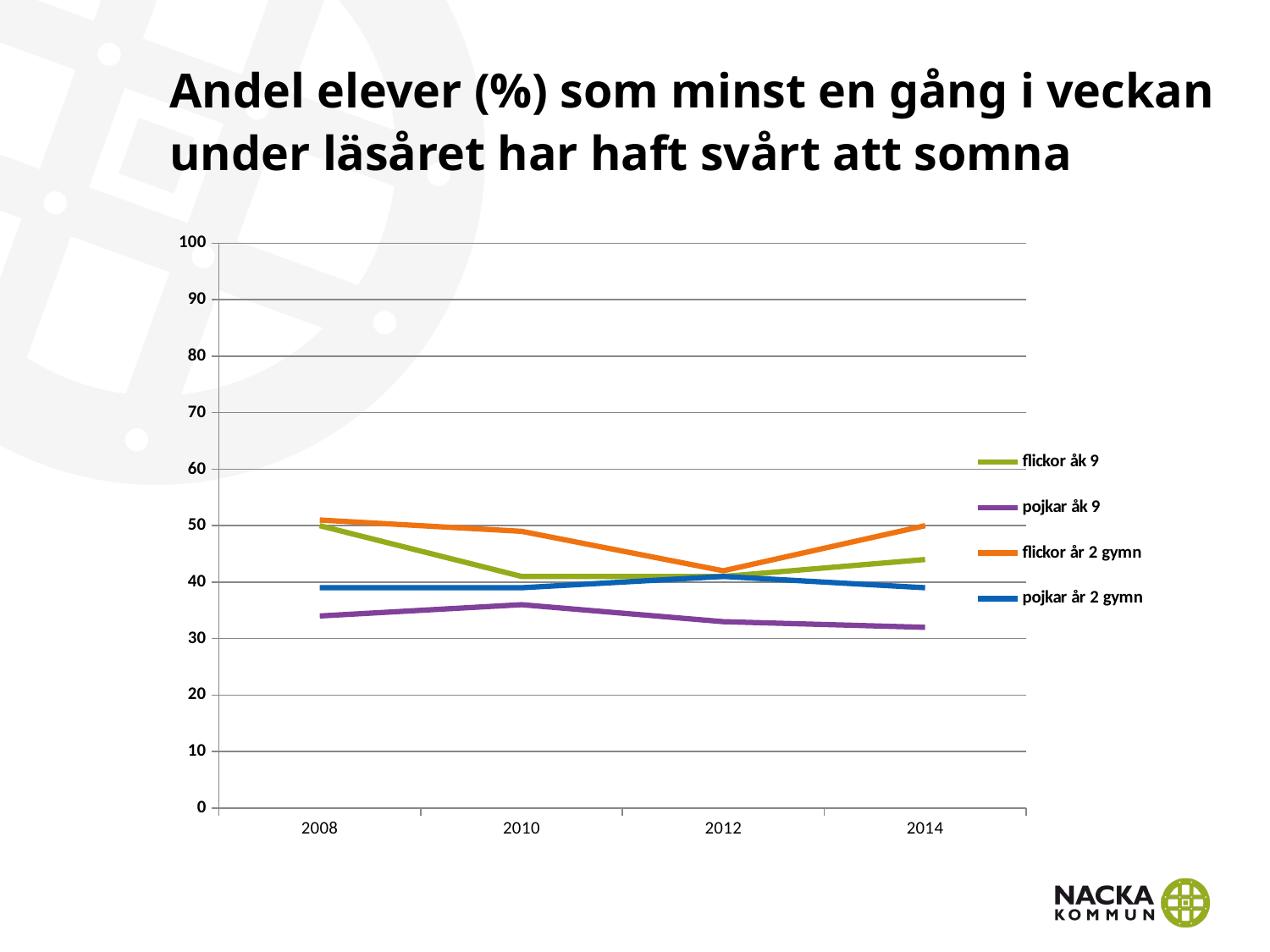
How many series does the legend list? 4 Which series has the highest value in 2014? flickor år 2 gymn What colour is the line for pojkar år 2 gymn? blue Is the value for pojkar åk 9 in 2008 greater or less than 40? less In 2008, which is larger: the value for pojkar åk 9 or the value for flickor år 2 gymn? flickor år 2 gymn Does the value for pojkar åk 9 rise or fall from 2010 to 2014? fall Which series has the lowest value in 2012? pojkar åk 9 How many years are shown on the x axis? 4 What kind of chart is shown on the slide? line chart Does the value for flickor år 2 gymn rise or fall from 2008 to 2012? fall Is the value for flickor år 2 gymn in 2012 greater or less than 50? less Is the value for flickor åk 9 in 2014 greater or less than 40? greater